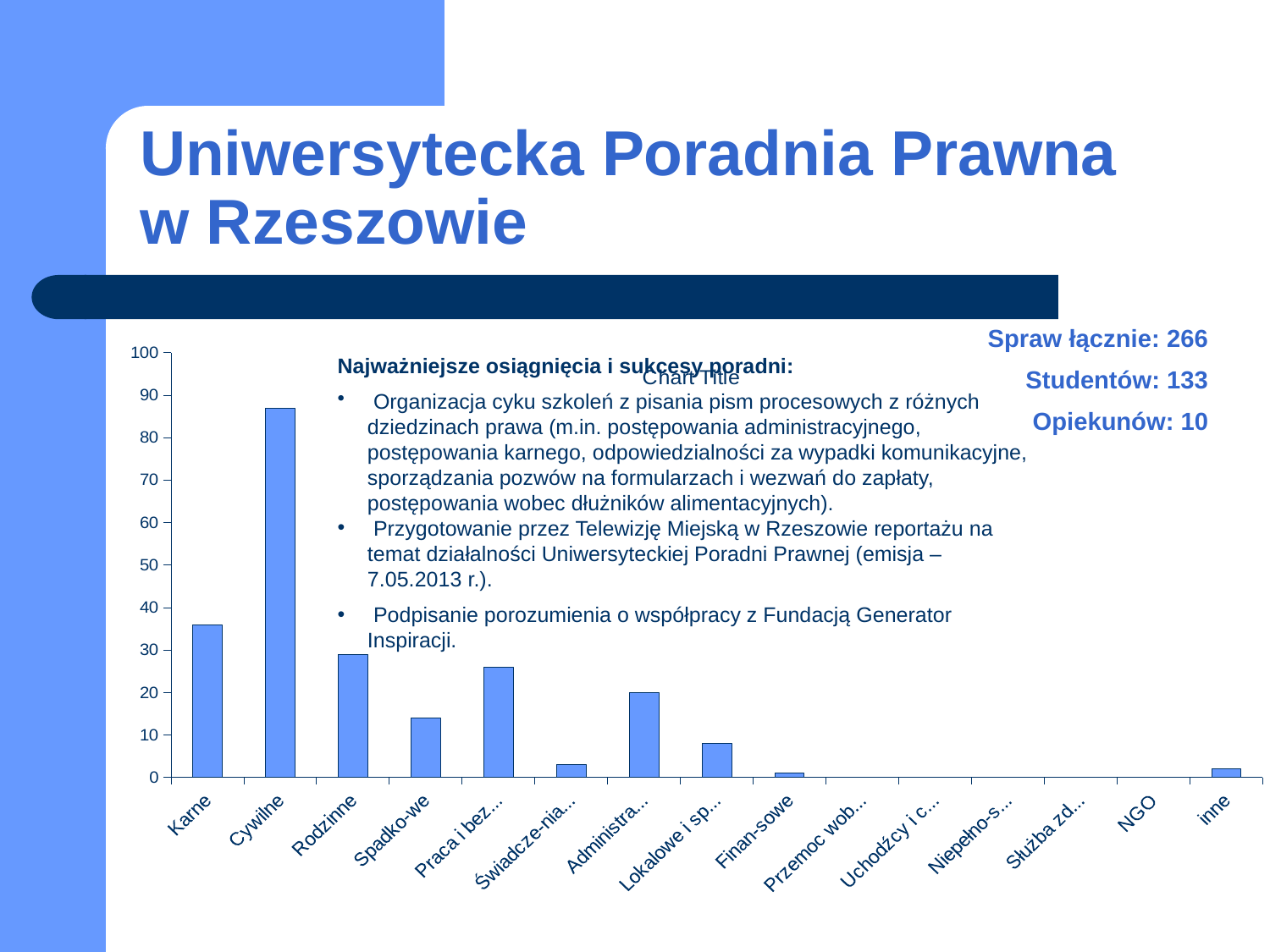
Is the value for Rodzinne greater or less than 20? greater Is the value for Spadko-we greater or less than 20? less Is the value for Lokalowe i sp... greater or less than 10? less What is the title shown above the chart? Chart Title Which category has the highest bar in the chart? Cywilne Which is larger, the value for Administra... or the value for Lokalowe i sp...? Administra... How many categories are shown on the x axis of the chart? 15 Which is larger, the value for Praca i bez... or the value for Spadko-we? Praca i bez... What kind of chart is shown on the slide? bar chart Which is larger, the value for Karne or the value for Rodzinne? Karne